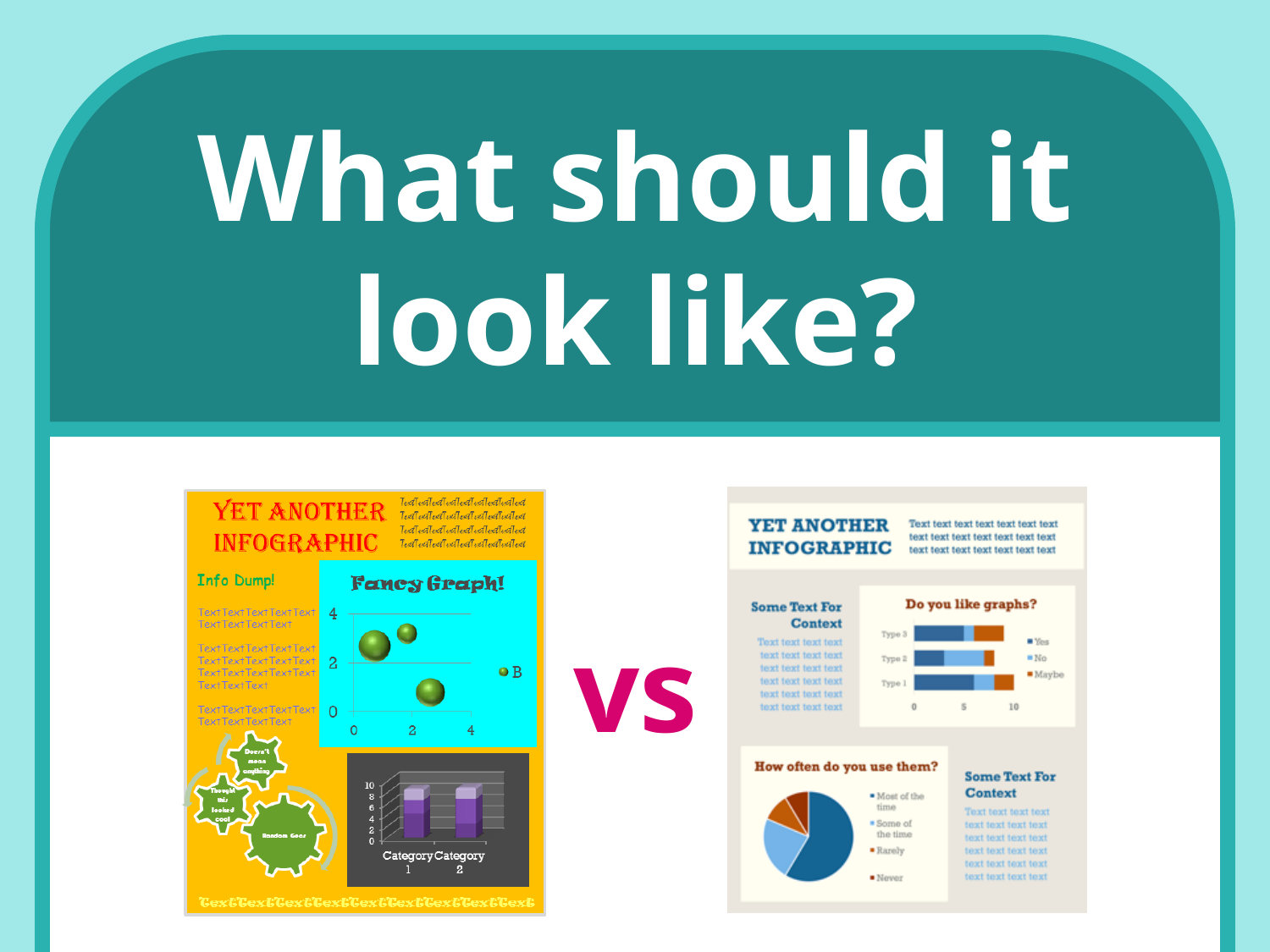
In the 'How often do you use them?' pie chart, how many slices does the legend list? 4 In the 'Do you like graphs?' chart, how many categories (types) are plotted? 3 In the 'How often do you use them?' pie chart, which category has the largest slice? Most of the time In the left-hand infographic's bar chart, is the value for Category 1 greater or less than 5? greater In the 'Do you like graphs?' chart, what are the legend entries? Yes, No, Maybe In the 'Do you like graphs?' chart, how many series does the legend list? 3 What kind of chart is 'Do you like graphs?'? Stacked bar chart In the 'Do you like graphs?' chart, is the total for Type 3 greater or less than 5? greater In the left-hand infographic, what is the title of the chart with green bubbles? Fancy Graph! What is the title of the stacked bar chart in the right-hand infographic? Do you like graphs? What kind of chart is 'How often do you use them?' in the right-hand infographic? Pie chart In the left-hand infographic's bar chart, how many categories are shown on the x axis? 2